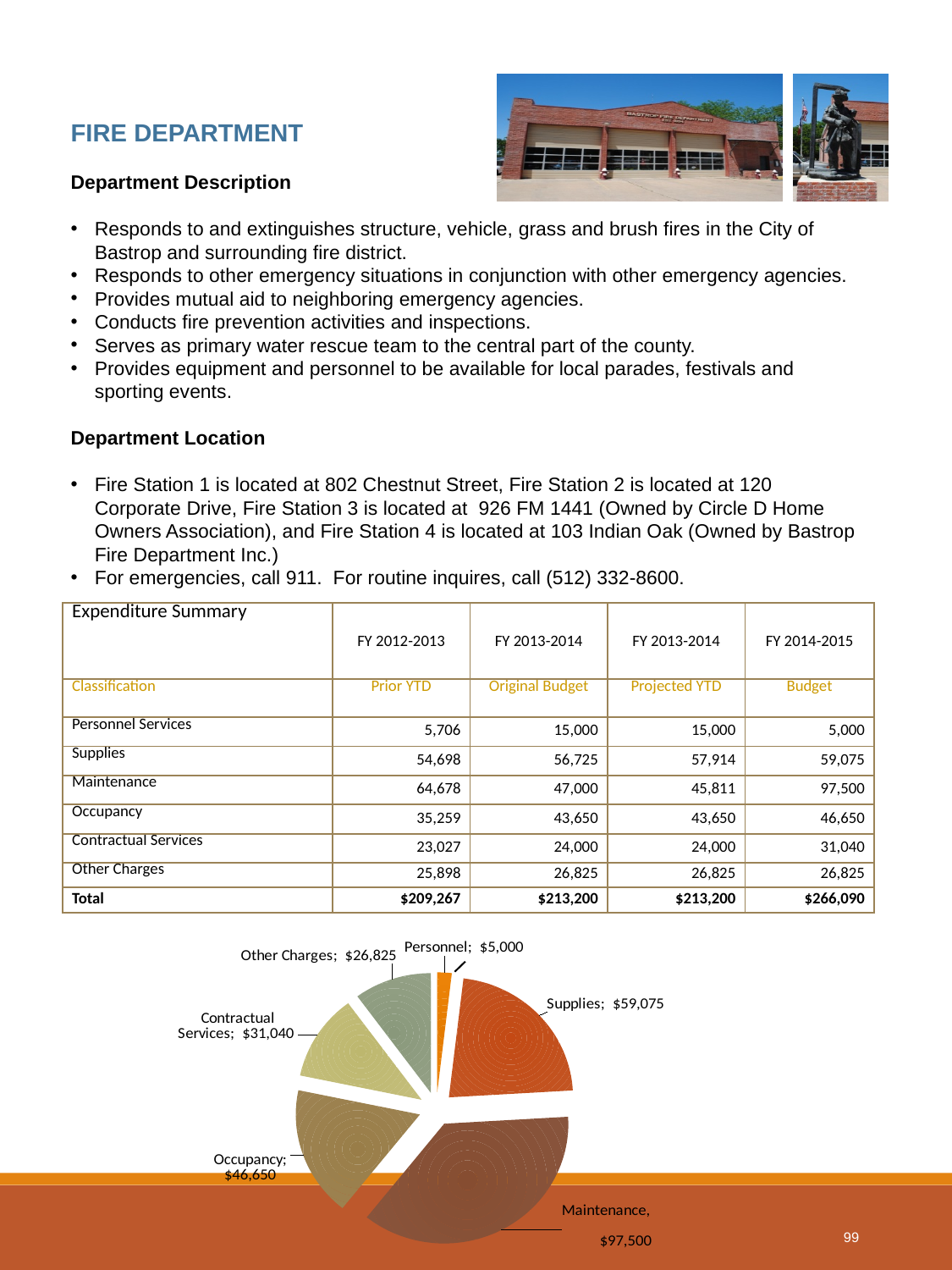
In the pie chart, which is larger, Occupancy or Contractual Services? Occupancy In the pie chart, what is the value for Other Charges? $26,825 How many slices does the pie chart have? 6 In the pie chart, what is the difference between Maintenance and Supplies? $38,425 In the pie chart, what is the value for Contractual Services? $31,040 What kind of chart is shown at the bottom of the slide? pie chart In the pie chart, what is the value for Maintenance? $97,500 Which category has the largest slice in the pie chart? Maintenance In the pie chart, what is the value for Occupancy? $46,650 In the pie chart, what is the difference between Other Charges and Personnel? $21,825 In the pie chart, what is the value for Supplies? $59,075 Which category has the smallest slice in the pie chart? Personnel